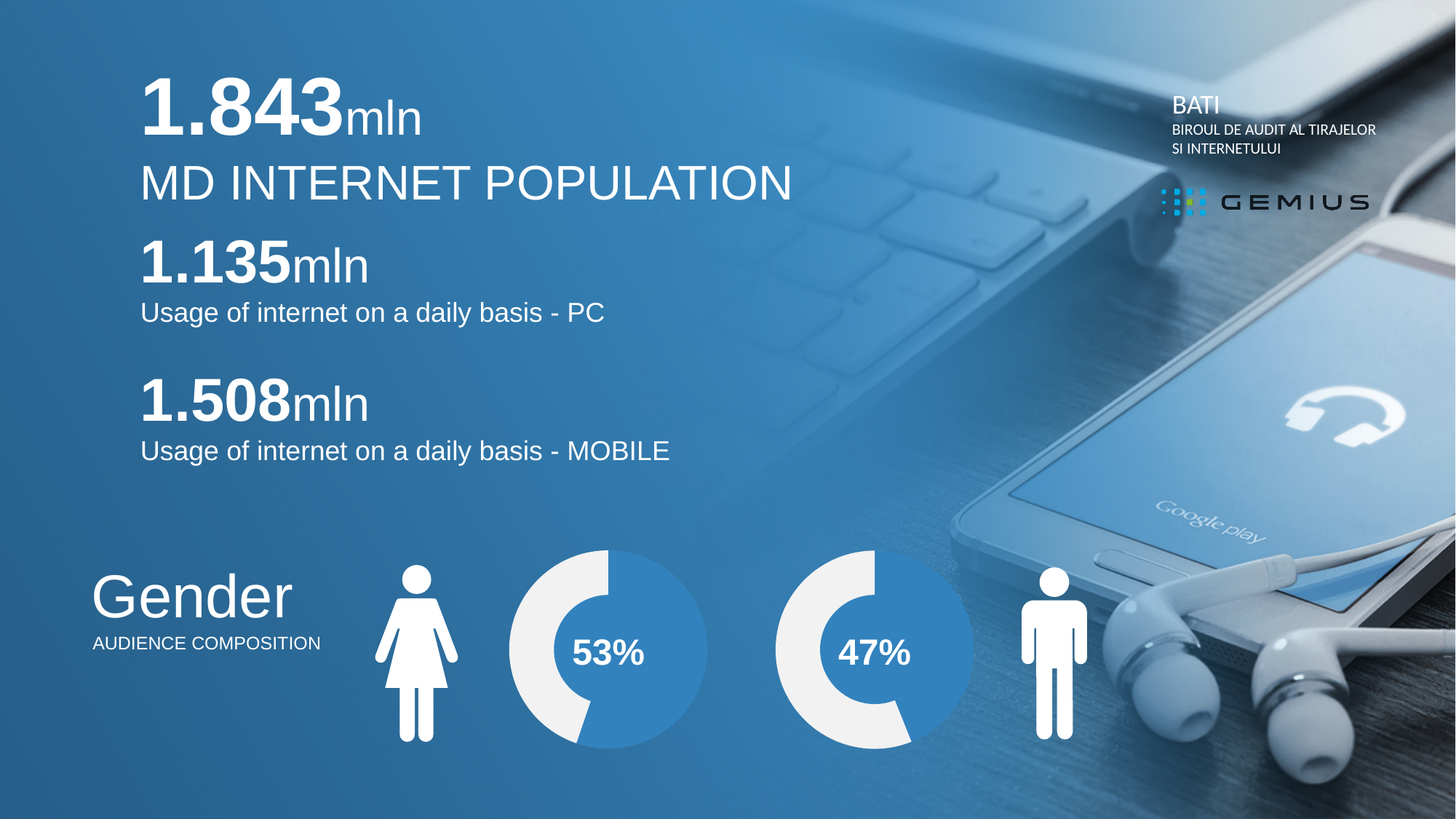
In the Gender audience composition charts, what is the difference in percentage points between the female share and the male share? 6 percentage points In the Gender audience composition charts, what colour is the filled portion of each doughnut? Blue What is the title of the section containing the two doughnut charts? Gender – Audience composition In the Gender audience composition charts, is the male share greater or less than 50%? less In the Gender audience composition charts, what share is shown for women (the doughnut next to the female icon)? 53% In the Gender audience composition charts, which gender has the larger share of the audience? Women What kind of chart is used to show the gender audience composition on the slide? Doughnut (pie) chart In the Gender audience composition charts, which gender has the smaller share of the audience? Men What do the female and male shares in the Gender audience composition charts add up to? 100% In the Gender audience composition charts, is the female share greater or less than 50%? greater In the Gender audience composition charts, what share is shown for men (the doughnut next to the male icon)? 47% How many doughnut charts are shown in the Gender audience composition section? 2